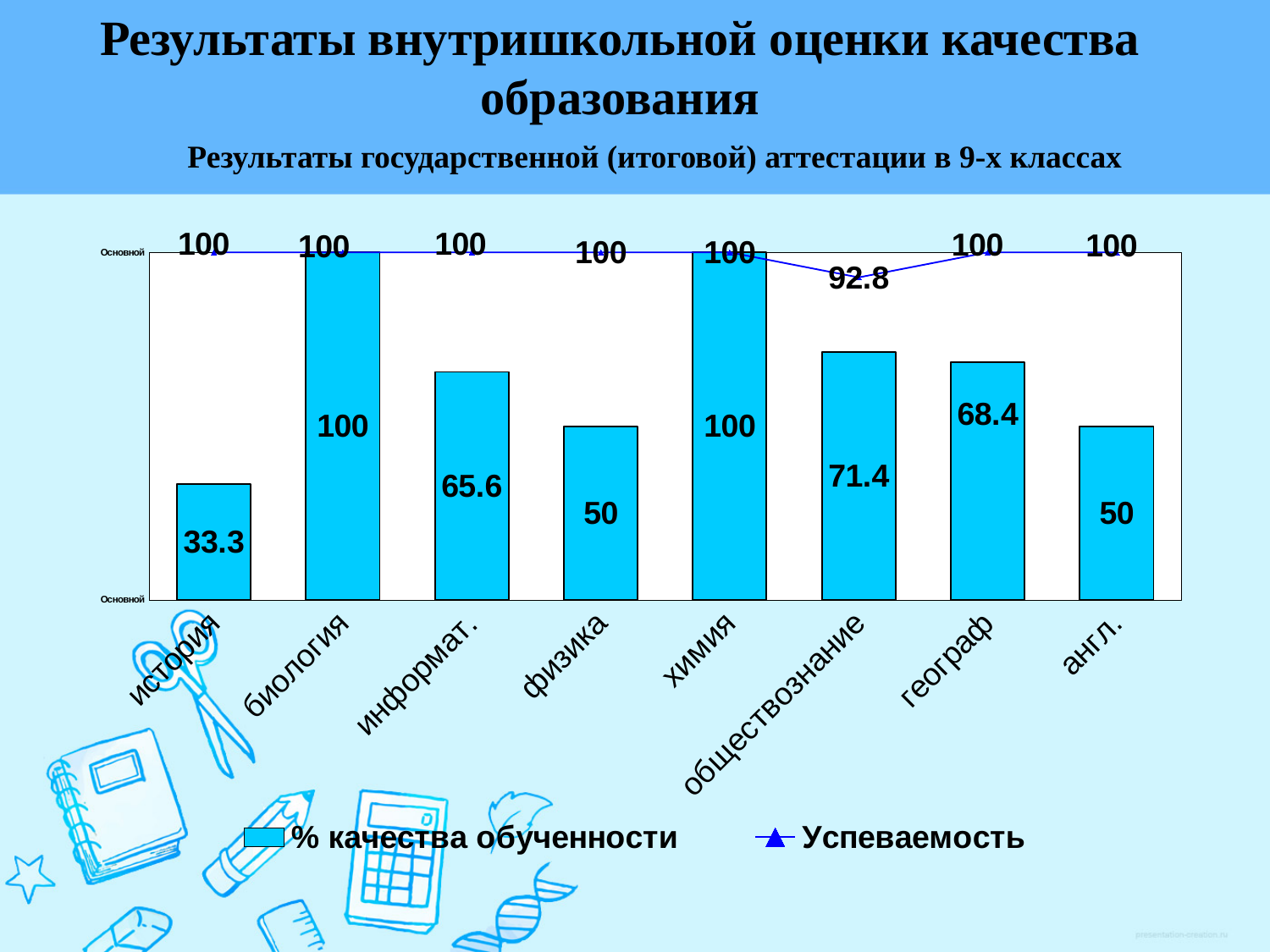
What is the difference between the % качества обученности values for информат. and физика? 15.6 What is the Успеваемость value for обществознание? 92.8 Which series is drawn as a line with triangle markers? Успеваемость What is the % качества обученности value for географ? 68.4 How many subjects have a % качества обученности value of 100? 2 Which subject has the lowest % качества обученности? история Which has a higher % качества обученности, обществознание or географ? обществознание How many subjects are shown on the x axis of the chart? 8 How many series does the chart legend list? 2 Which subject has the lowest Успеваемость value? обществознание What is the % качества обученности value for обществознание? 71.4 What is the % качества обученности value for история? 33.3